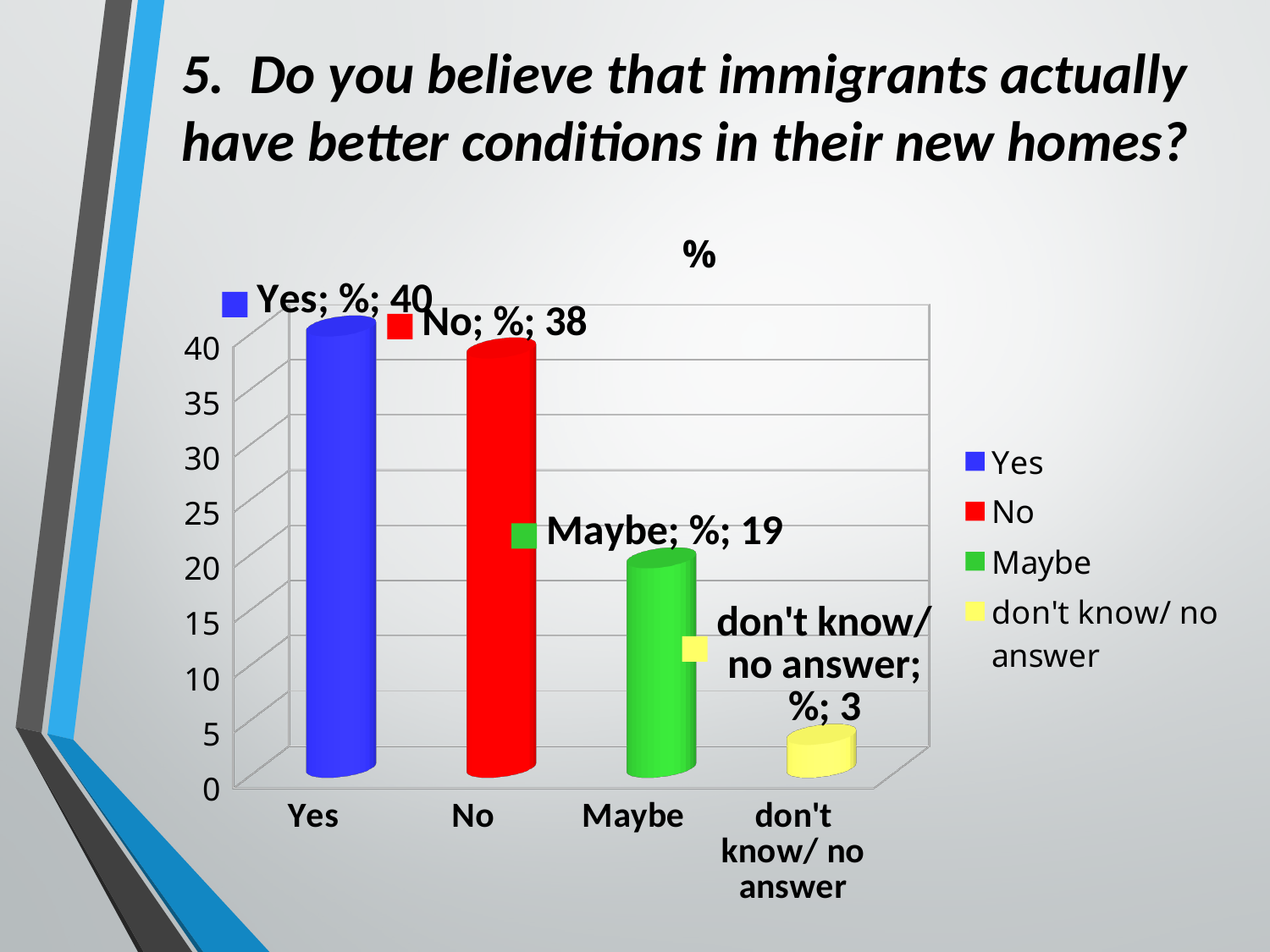
What is the title of the chart? % What is the value for Yes? 40 What is the difference between the values for Yes and No? 2 What kind of chart is shown on the slide? Bar chart Which category has the highest value? Yes What is the value for don't know/ no answer? 3 How many categories are shown on the x axis? 4 Which category has the lowest value? don't know/ no answer Which is larger, the value for Maybe or the value for don't know/ no answer? Maybe What is the difference between the values for No and Maybe? 19 What is the value for Maybe? 19 What is the value for No? 38